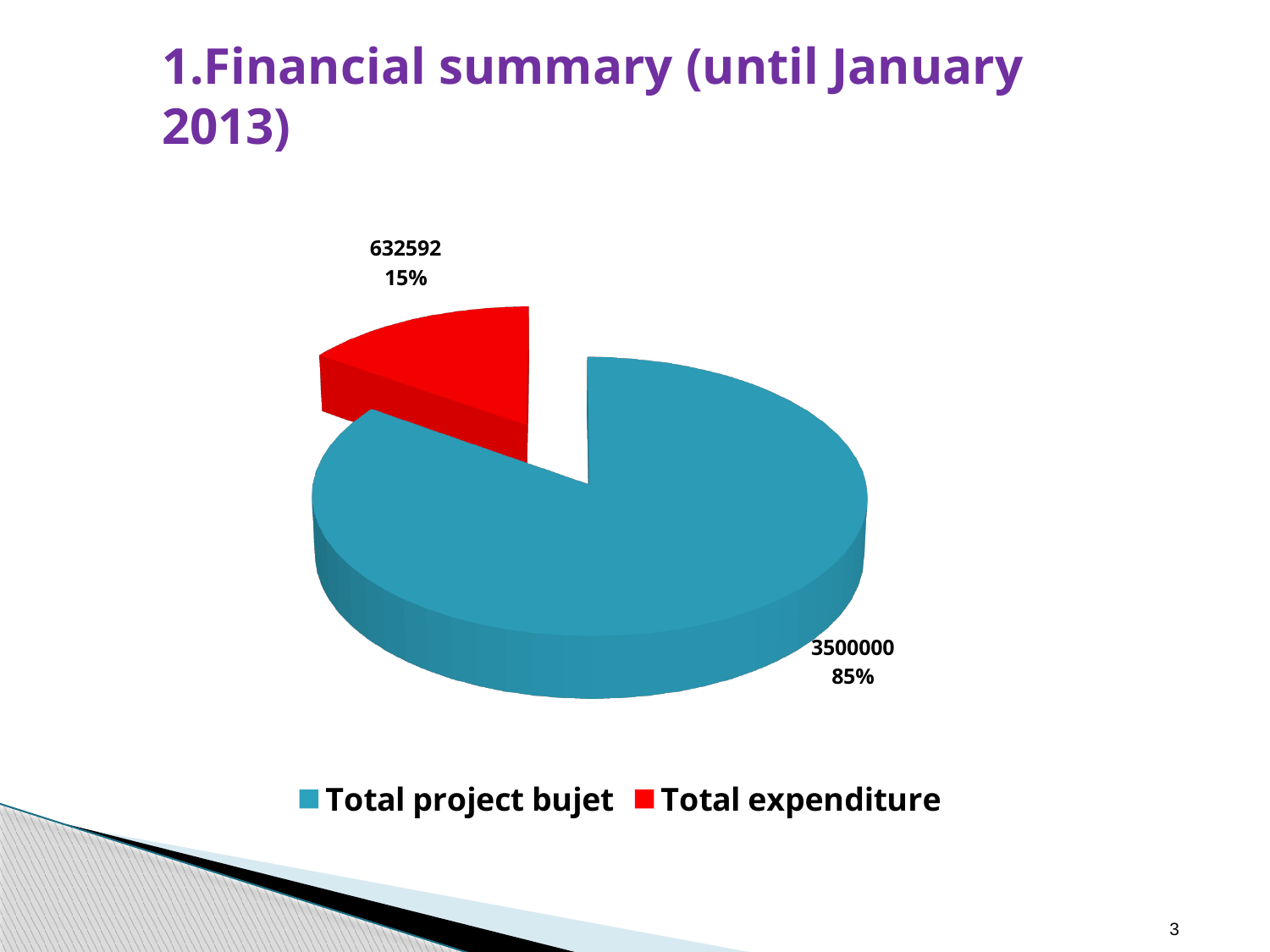
What is the value for Total expenditure? 632592 What is the difference between the Total project bujet value and the Total expenditure value? 2867408 Which is larger, Total project bujet or Total expenditure? Total project bujet How many entries does the legend list? 2 What kind of chart is shown on the slide? pie chart What share of the pie does Total expenditure represent? 15% What colour is the Total expenditure slice? red What share of the pie does Total project bujet represent? 85% Which slice is the largest? Total project bujet What is the value for Total project bujet? 3500000 How many slices does the pie chart have? 2 Which slice is the smallest? Total expenditure